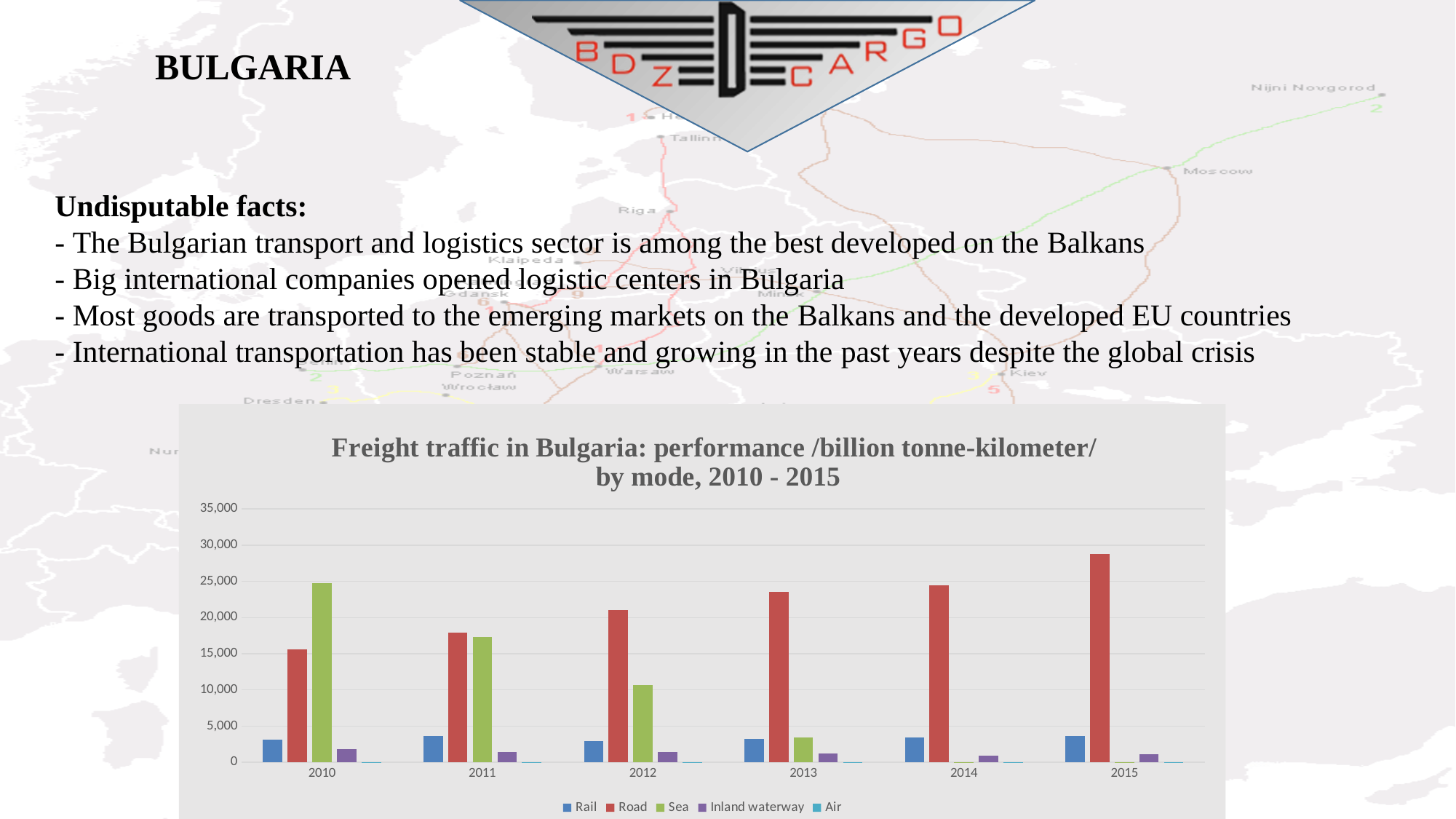
In 2012, which is larger, the Road value or the Sea value? Road Does the Sea value rise or fall from 2010 to 2013? falls Is the Sea value for 2010 greater or less than 20,000? greater Is the Road value for 2015 greater or less than 25,000? greater Which mode has the highest value in 2010? Sea What kind of chart is shown on the slide? bar chart Does the Road value rise or fall from 2010 to 2015? rises What colour are the Road bars in the chart? red In which year is the Road value highest? 2015 How many series does the legend of the freight traffic chart list? 5 Is the Road value for 2010 greater or less than 20,000? less How many years are shown on the x axis of the freight traffic chart? 6